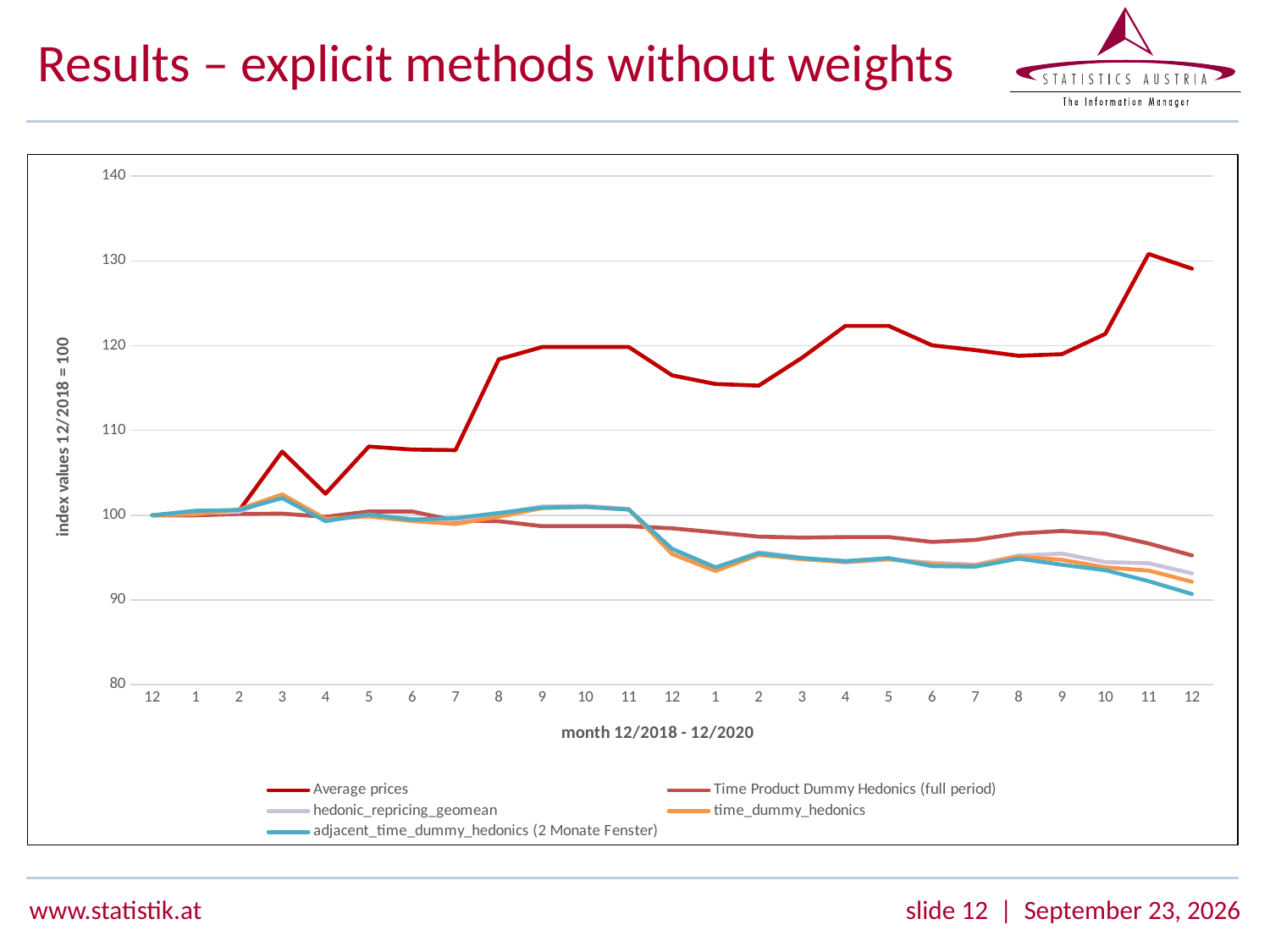
Is the value of Time Product Dummy Hedonics (full period) at the final month 12/2020 greater or less than 100? less Is the value of Average prices at month 8 of 2019 greater or less than 110? greater Which series has the lowest value at the final month 12/2020? adjacent_time_dummy_hedonics (2 Monate Fenster) Is the value of adjacent_time_dummy_hedonics (2 Monate Fenster) at the final month 12/2020 greater or less than 100? less What kind of chart is shown on the slide? line chart What is the title of the y axis? index values 12/2018 = 100 Does the Average prices series overall rise or fall from 12/2018 to 12/2020? rise Which series has the highest value at the final month 12/2020? Average prices How many monthly points are plotted along the x axis? 25 At the final month 12/2020, which is larger: Average prices or Time Product Dummy Hedonics (full period)? Average prices How many series does the legend list? 5